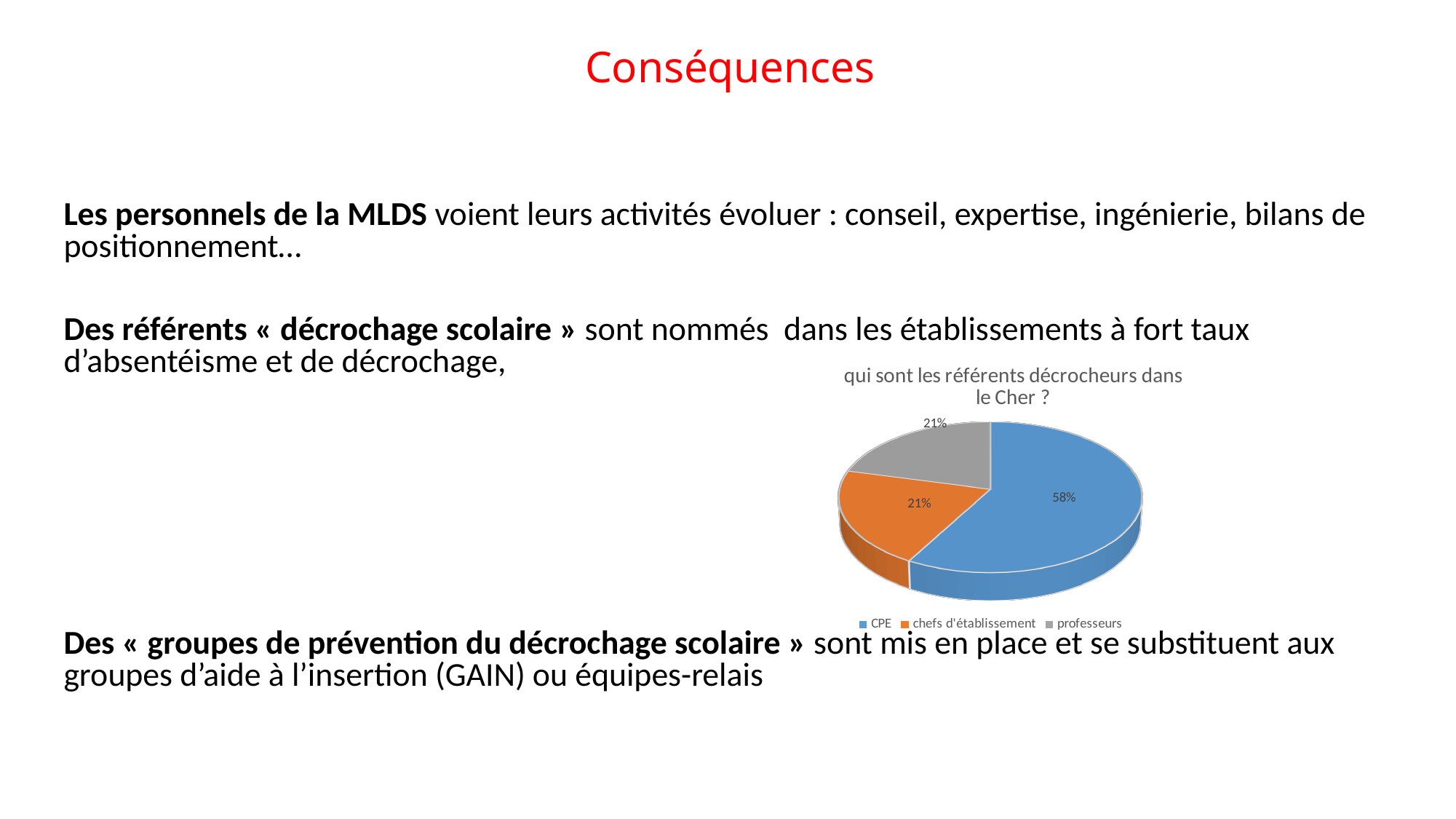
What share of the pie does CPE represent? 58% How many slices does the pie chart have? 3 Do chefs d'établissement and professeurs have the same share of the pie? yes What kind of chart is shown on the slide? pie chart How many entries does the legend list? 3 What is the value shown for professeurs? 21% What colour is the CPE slice in the pie chart? blue Which category has the largest slice of the pie? CPE What is the value shown for chefs d'établissement? 21% What is the difference in percentage points between the CPE slice and the professeurs slice? 37 Which is larger, the slice for CPE or the slice for chefs d'établissement? CPE What is the title of the pie chart? qui sont les référents décrocheurs dans le Cher ?